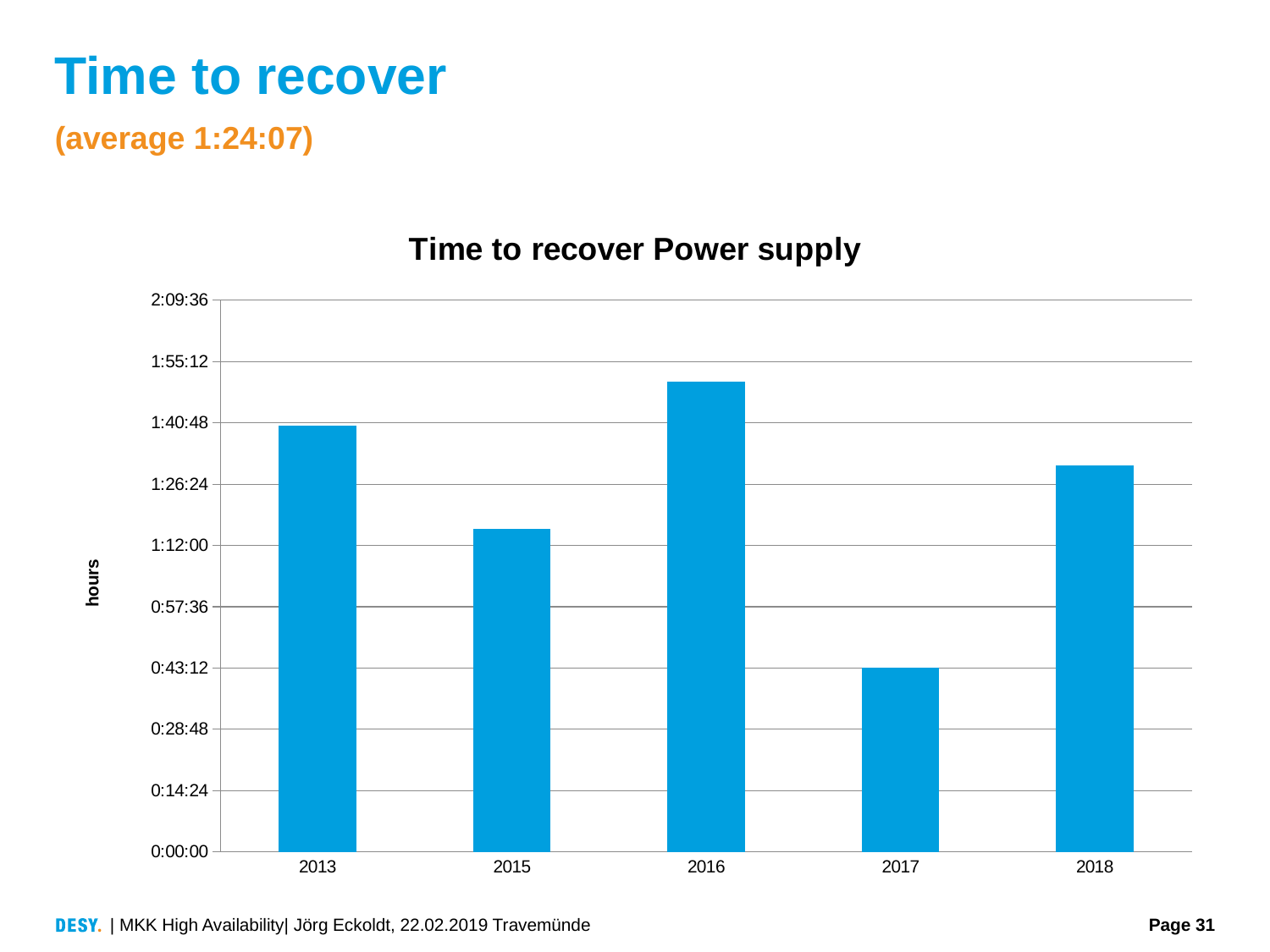
How many years are shown on the x axis of the chart? 5 Is the time to recover for 2015 greater or less than 1:12:00? greater Is the time to recover for 2018 greater or less than 1:40:48? less Is the time to recover for 2016 greater or less than 1:40:48? greater What kind of chart is shown on the slide? bar chart Which year has the lowest time to recover? 2017 Which year has the larger time to recover, 2018 or 2017? 2018 Which year has the larger time to recover, 2013 or 2015? 2013 What is the label on the vertical axis of the chart? hours What is the title of the chart? Time to recover Power supply Which year has the highest time to recover? 2016